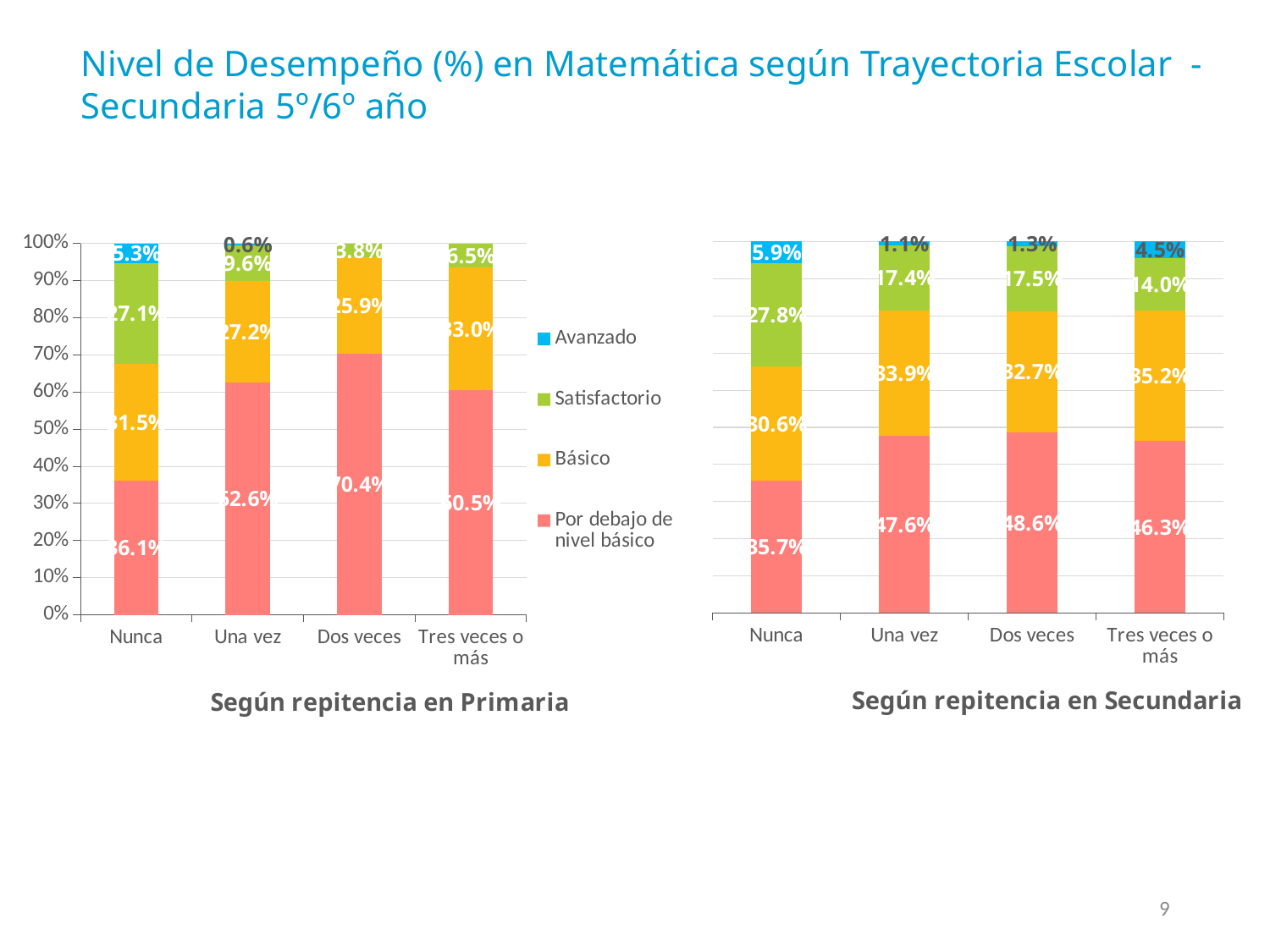
In the 'Según repitencia en Secundaria' chart, which category has the highest value for 'Por debajo de nivel básico'? Dos veces What kind of chart is the 'Según repitencia en Primaria' chart? Stacked bar chart How many categories are shown on the x axis of the 'Según repitencia en Secundaria' chart? 4 In the 'Según repitencia en Primaria' chart, what is the value for 'Por debajo de nivel básico' for 'Dos veces'? 70.4% In the 'Según repitencia en Primaria' chart, which category has the lowest value for 'Por debajo de nivel básico'? Nunca In the 'Según repitencia en Secundaria' chart, what is the value for 'Satisfactorio' for 'Tres veces o más'? 14.0% In the 'Según repitencia en Primaria' chart, which is larger: the 'Satisfactorio' value for 'Nunca' or for 'Dos veces'? Nunca How many series does the legend list? 4 In the 'Según repitencia en Secundaria' chart, what is the difference between the 'Por debajo de nivel básico' values for 'Una vez' and 'Nunca'? 11.9% In the 'Según repitencia en Secundaria' chart, what is the value for 'Avanzado' for 'Nunca'? 5.9% In the 'Según repitencia en Primaria' chart, what is the value for 'Satisfactorio' for 'Una vez'? 9.6% In the 'Según repitencia en Secundaria' chart, what is the value for 'Básico' for 'Tres veces o más'? 35.2%